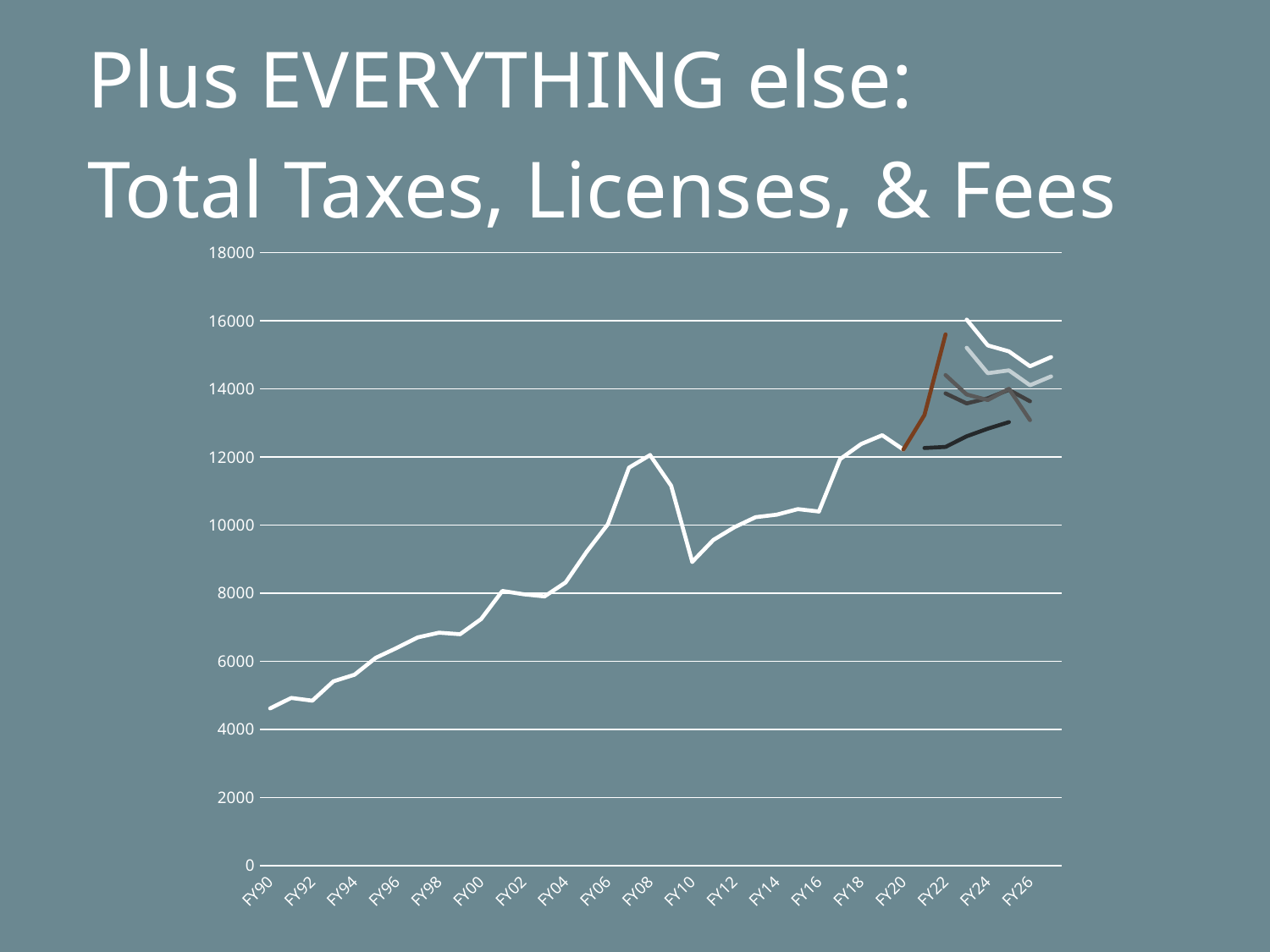
Do the values generally rise or fall from FY90 to FY20? rise What is the highest value shown on the y axis? 18000 Is the value for FY90 greater or less than 4000? greater Is the value for FY90 greater or less than 6000? less Is the value for FY10 greater or less than 8000? greater Do the values rise or fall between FY08 and FY10? fall What is the title of the chart on the slide? Plus EVERYTHING else: Total Taxes, Licenses, & Fees How many fiscal-year labels are shown along the x axis? 19 What kind of chart is shown on the slide? line chart